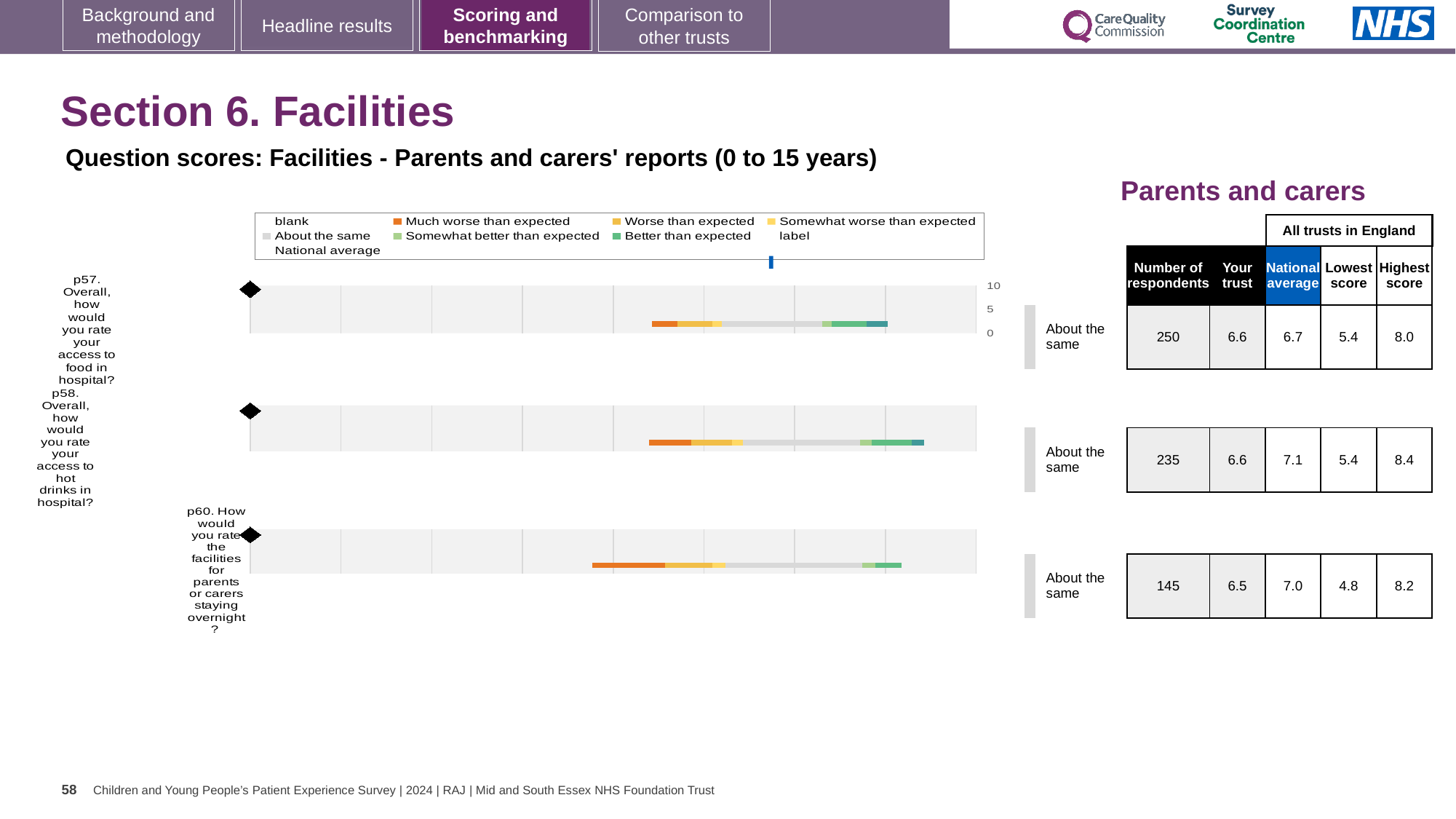
What benchmark category label is shown next to each of the three question bars? About the same What colour does the legend use for 'Much worse than expected'? Orange What is the difference between the national average and the 'Your trust' score for p58? 0.5 What is the difference between the highest score and the lowest score for p57? 2.6 For p60, which is larger: the 'Your trust' score or the national average? National average Which question has the lowest 'Lowest score' across all trusts in England? p60 What is the 'Your trust' score for p57 (access to food in hospital)? 6.6 What kind of chart is used to show the question scores for p57, p58 and p60? Bar chart How many respondents answered p60 (facilities for parents or carers staying overnight)? 145 Which question has the highest 'Highest score' across all trusts in England? p58 How many survey questions are plotted on the slide? 3 What is the national average score for p58 (access to hot drinks in hospital)? 7.1